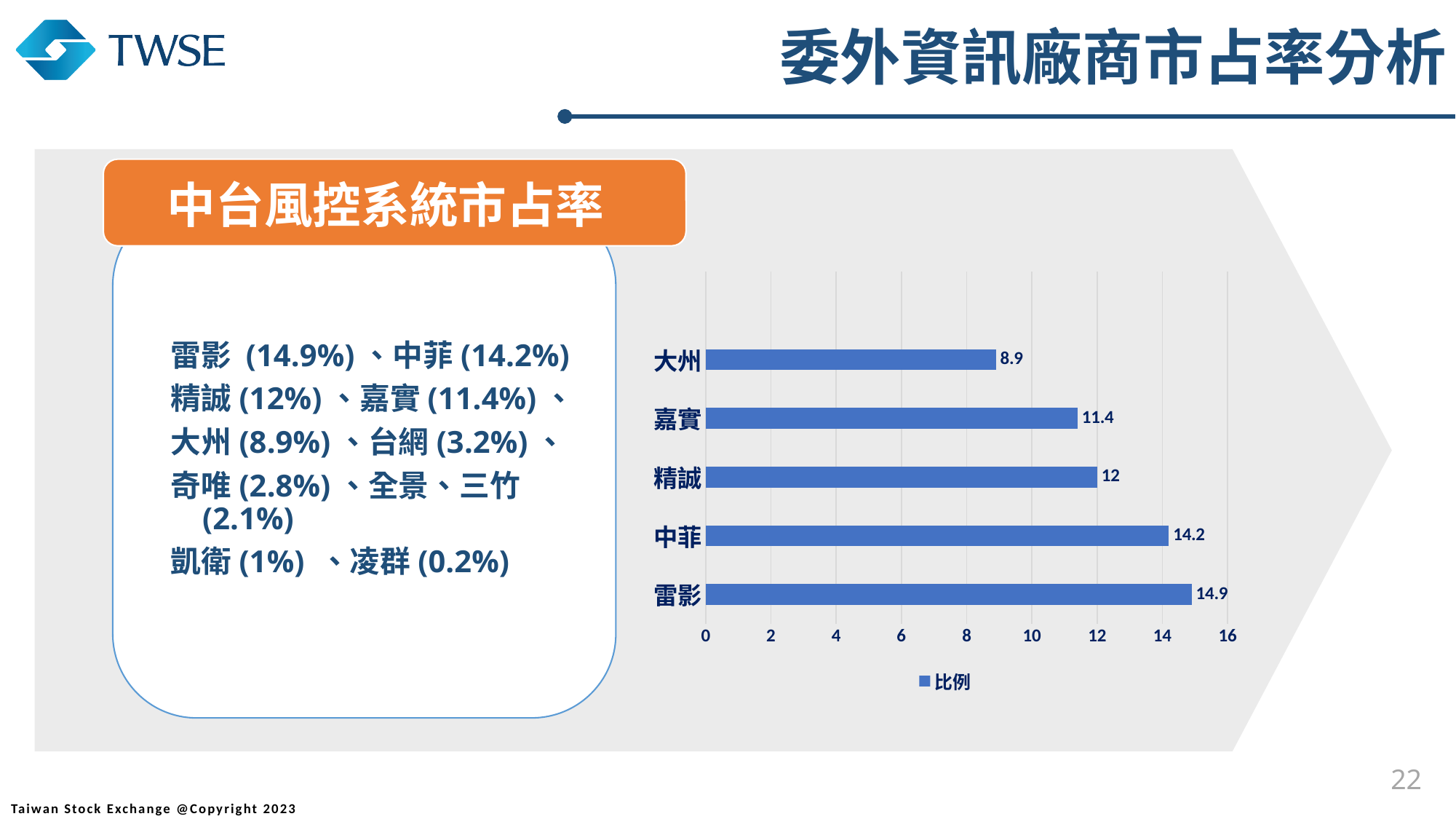
What is the value for 大州 in the chart? 8.9 What is the value for 精誠 in the chart? 12 How many categories are shown in the chart? 5 What is the name of the series shown in the chart legend? 比例 Is the value for 大州 greater or less than 10? less What is the value for 中菲 in the chart? 14.2 What is the difference between the values for 雷影 and 中菲? 0.7 Which category has the highest value in the chart? 雷影 What kind of chart is shown on the slide? bar chart What is the value for 嘉實 in the chart? 11.4 Which has a larger value, 精誠 or 嘉實? 精誠 Which category has the lowest value in the chart? 大州